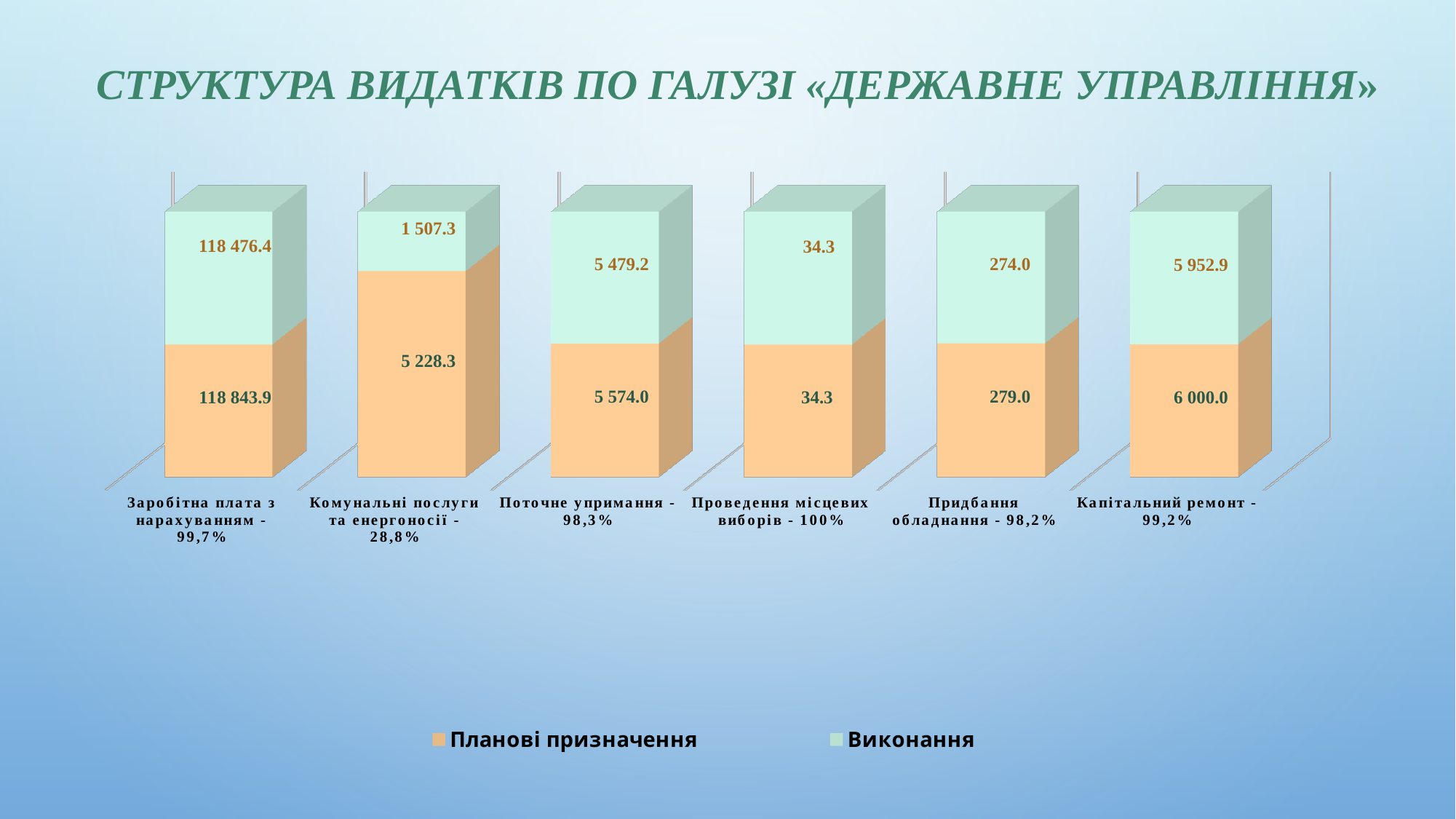
How many series does the legend list? 2 How many categories are shown in the chart? 6 Which is larger: Планові призначення for Капітальний ремонт or Планові призначення for Поточне упримання? Капітальний ремонт What is the value of Виконання for Капітальний ремонт? 5 952.9 What is the value of Виконання for Комунальні послуги та енергоносії? 1 507.3 What is the value of Планові призначення for Придбання обладнання? 279.0 Which category has the lowest value of Виконання? Проведення місцевих виборів What is the value of Планові призначення for Заробітна плата з нарахуванням? 118 843.9 What kind of chart is shown on the slide? Stacked bar chart Which category has the highest value of Планові призначення? Заробітна плата з нарахуванням What is the difference between Планові призначення and Виконання for Комунальні послуги та енергоносії? 3 721.0 What is the difference between Планові призначення and Виконання for Капітальний ремонт? 47.1